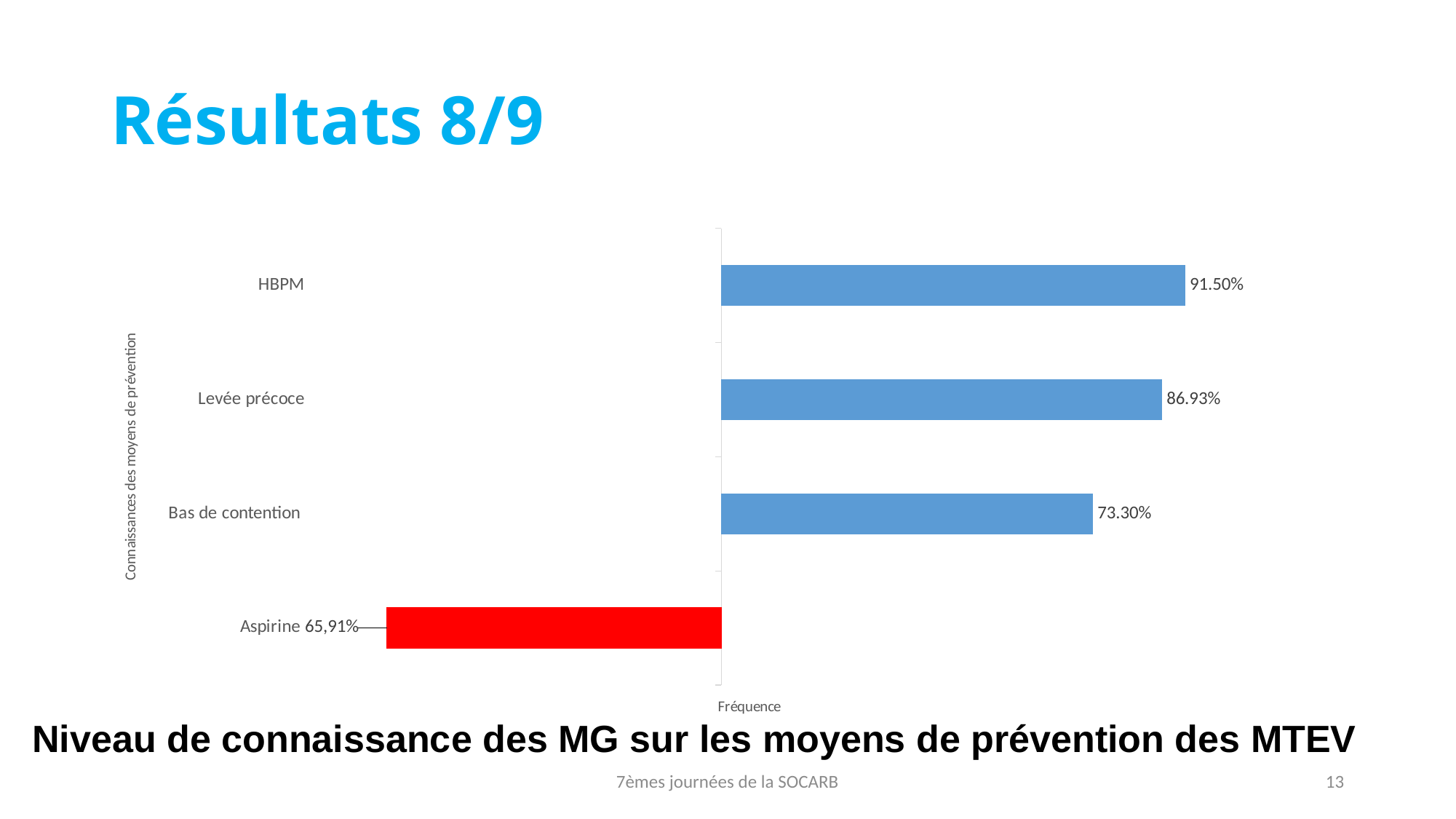
How many categories are shown in the chart? 4 What is the difference between the values for HBPM and Levée précoce? 4.57% What is the value for Levée précoce? 86.93% Which category has the highest value? HBPM Which is larger, the value for Bas de contention or the value for Levée précoce? Levée précoce What is the value for HBPM? 91.50% What value is shown for Aspirine? 65,91% What is the value for Bas de contention? 73.30% Which category has the lowest value? Aspirine What colour is the bar for Aspirine? Red What is the difference between the values for Levée précoce and Bas de contention? 13.63% What kind of chart is shown on the slide? Bar chart